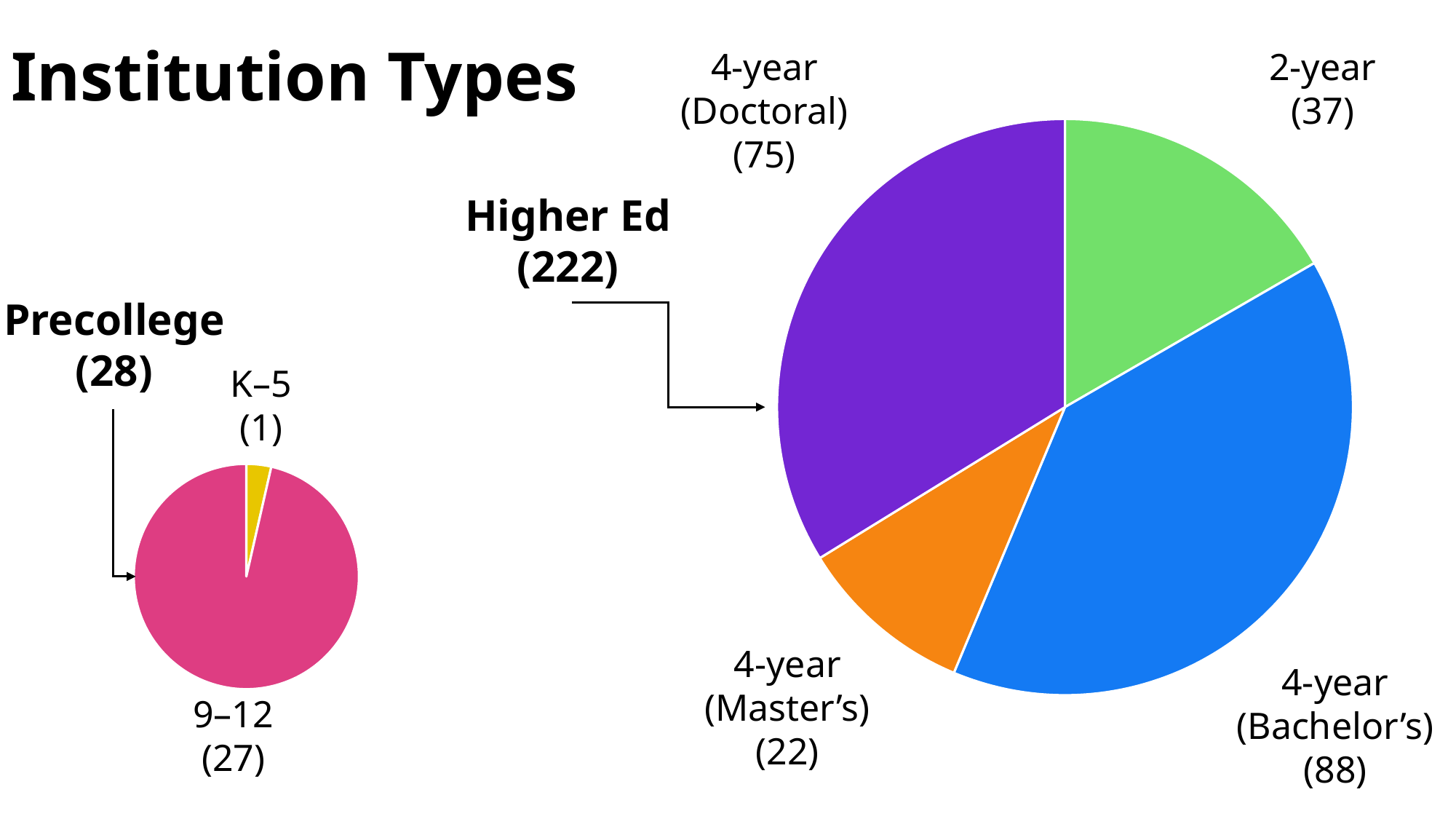
What is the total shown for the Higher Ed pie chart? 222 In the Higher Ed pie chart, which is larger: 2-year or 4-year (Master's)? 2-year In the Higher Ed pie chart, what is the value for 2-year institutions? 37 In the Higher Ed pie chart, what is the difference between 4-year (Bachelor's) and 4-year (Doctoral)? 13 What kind of chart is used for the Precollege data? Pie chart How many categories does the Higher Ed pie chart show? 4 How many categories does the Precollege pie chart show? 2 In the Higher Ed pie chart, which category has the largest slice? 4-year (Bachelor's) In the Precollege pie chart, what is the value for 9–12? 27 In the Higher Ed pie chart, which category has the smallest slice? 4-year (Master's) In the Precollege pie chart, what is the difference between 9–12 and K–5? 26 In the Higher Ed pie chart, what is the value for 4-year (Bachelor's)? 88